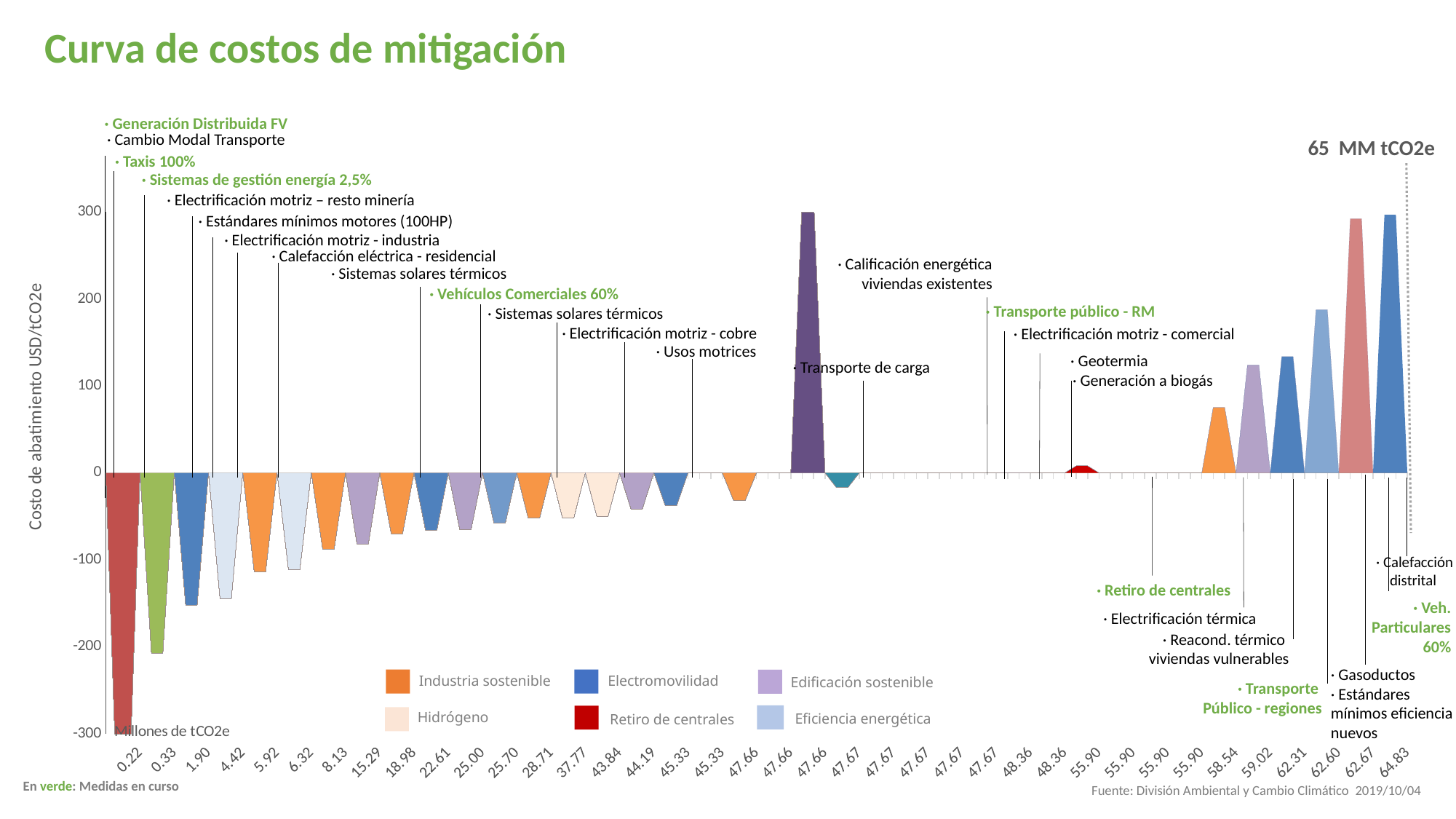
Which measure has the lowest abatement cost on the chart? Generación Distribuida FV What is the title of the chart? Curva de costos de mitigación Is the value for Gasoductos greater or less than 100? greater Is the value for Electrificación térmica greater or less than 100? less How many series does the legend list? 6 Is the value for Calificación energética viviendas existentes greater or less than 200? greater Do the abatement cost values generally rise or fall from left to right along the x axis? Rise What is the label of the vertical axis? Costo de abatimiento USD/tCO2e What kind of chart is shown on the slide? Area chart